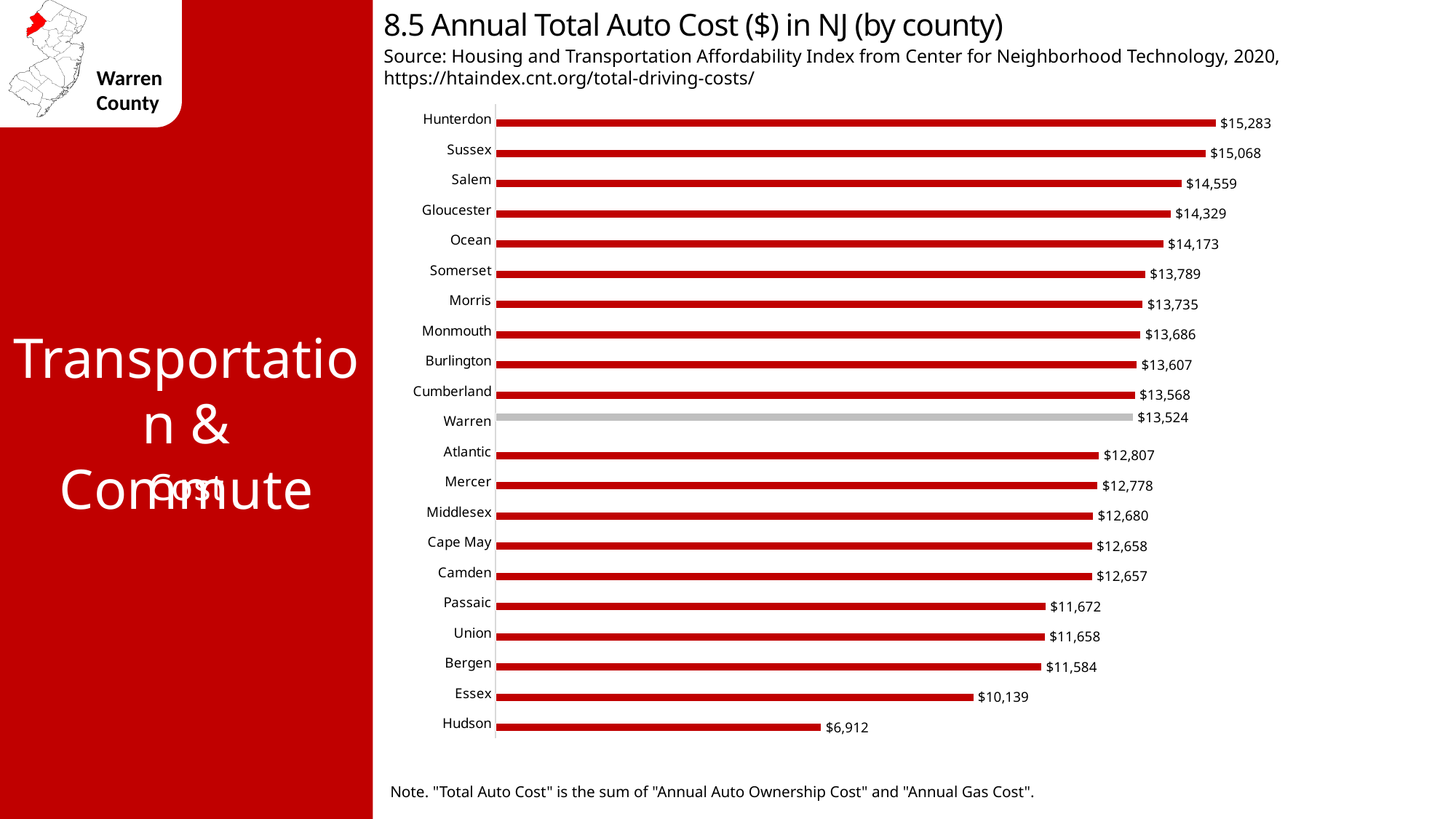
Which county has the highest annual total auto cost? Hunterdon What is the annual total auto cost for Essex County? $10,139 What is the difference in annual total auto cost between Warren and Atlantic counties? $717 Which county has the lowest annual total auto cost? Hudson Which county has a higher annual total auto cost, Sussex or Salem? Sussex What is the difference in annual total auto cost between Hunterdon and Hudson counties? $8,371 What is the annual total auto cost for Warren County? $13,524 What type of chart is used to show annual total auto cost by county? Bar chart How many counties are shown in the chart? 21 Which county has a higher annual total auto cost, Bergen or Essex? Bergen Which county's bar is shown in gray instead of red? Warren What is the annual total auto cost for Hunterdon County? $15,283